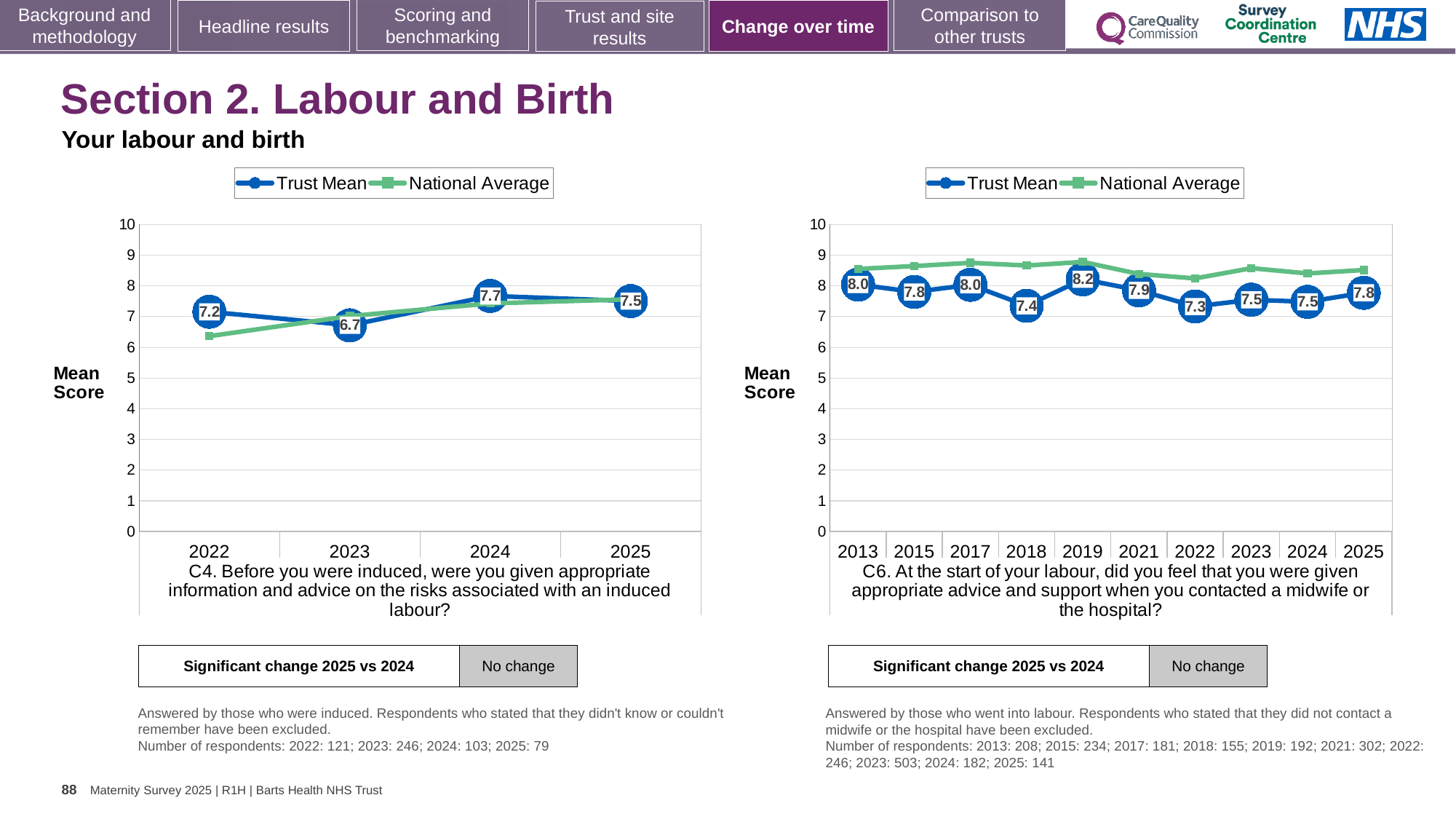
In the C4 chart on the left, how many years are plotted on the x axis? 4 In the C6 chart on the right, how many years are plotted on the x axis? 10 In the C6 chart on the right, what is the difference between the Trust Mean in 2025 and in 2024? 0.3 In the C6 chart on the right, which year has the lowest Trust Mean? 2022 In the C4 chart on the left, is the National Average for 2022 greater or less than 7? less In the C6 chart on the right, which is larger, the Trust Mean for 2018 or for 2021? 2021 In the C4 chart on the left, what is the difference between the Trust Mean in 2024 and in 2023? 1.0 In the C4 chart on the left, which year has the highest Trust Mean? 2024 In the C4 chart on the left, what is the Trust Mean for 2023? 6.7 In the C6 chart on the right, what is the Trust Mean for 2019? 8.2 How many series does the legend of the C6 chart on the right list? 2 What type of chart is the C4 chart on the left? Line chart